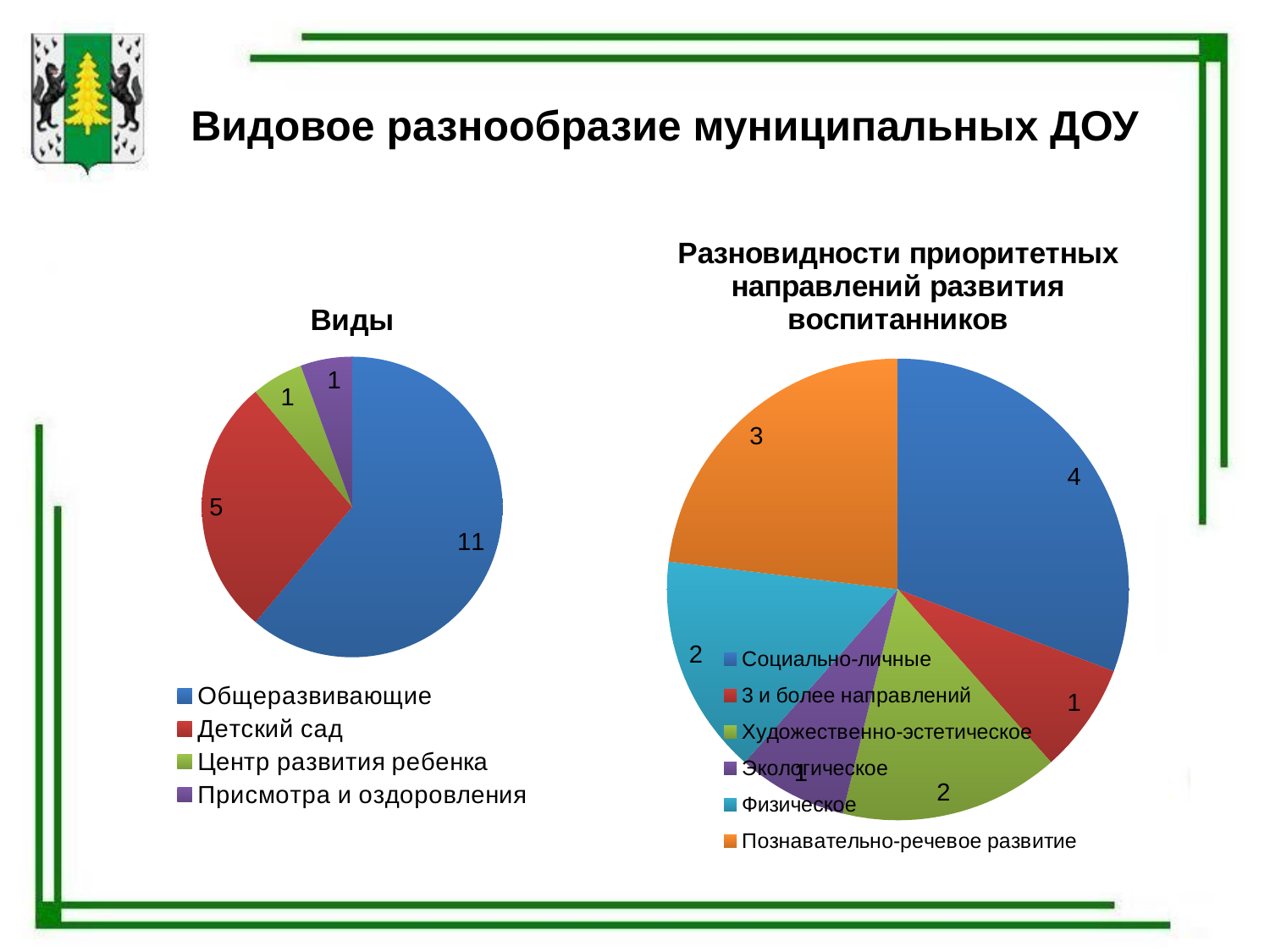
In the "Разновидности приоритетных направлений развития воспитанников" pie chart, what is the value for Социально-личные? 4 In the "Виды" pie chart, how many categories does the legend list? 4 In the "Виды" pie chart, what is the value for Общеразвивающие? 11 In the "Разновидности приоритетных направлений развития воспитанников" pie chart, what colour is the Физическое slice? Light blue In the "Разновидности приоритетных направлений развития воспитанников" pie chart, what is the value for Познавательно-речевое развитие? 3 In the "Виды" pie chart, what is the value for Детский сад? 5 In the "Разновидности приоритетных направлений развития воспитанников" pie chart, how many categories does the legend list? 6 In the "Виды" pie chart, what is the difference between the values for Общеразвивающие and Детский сад? 6 What kind of chart is the "Виды" chart? Pie chart In the "Разновидности приоритетных направлений развития воспитанников" pie chart, which is larger: Физическое or Познавательно-речевое развитие? Познавательно-речевое развитие In the "Разновидности приоритетных направлений развития воспитанников" pie chart, which category has the largest slice? Социально-личные In the "Виды" pie chart, which category has the largest slice? Общеразвивающие